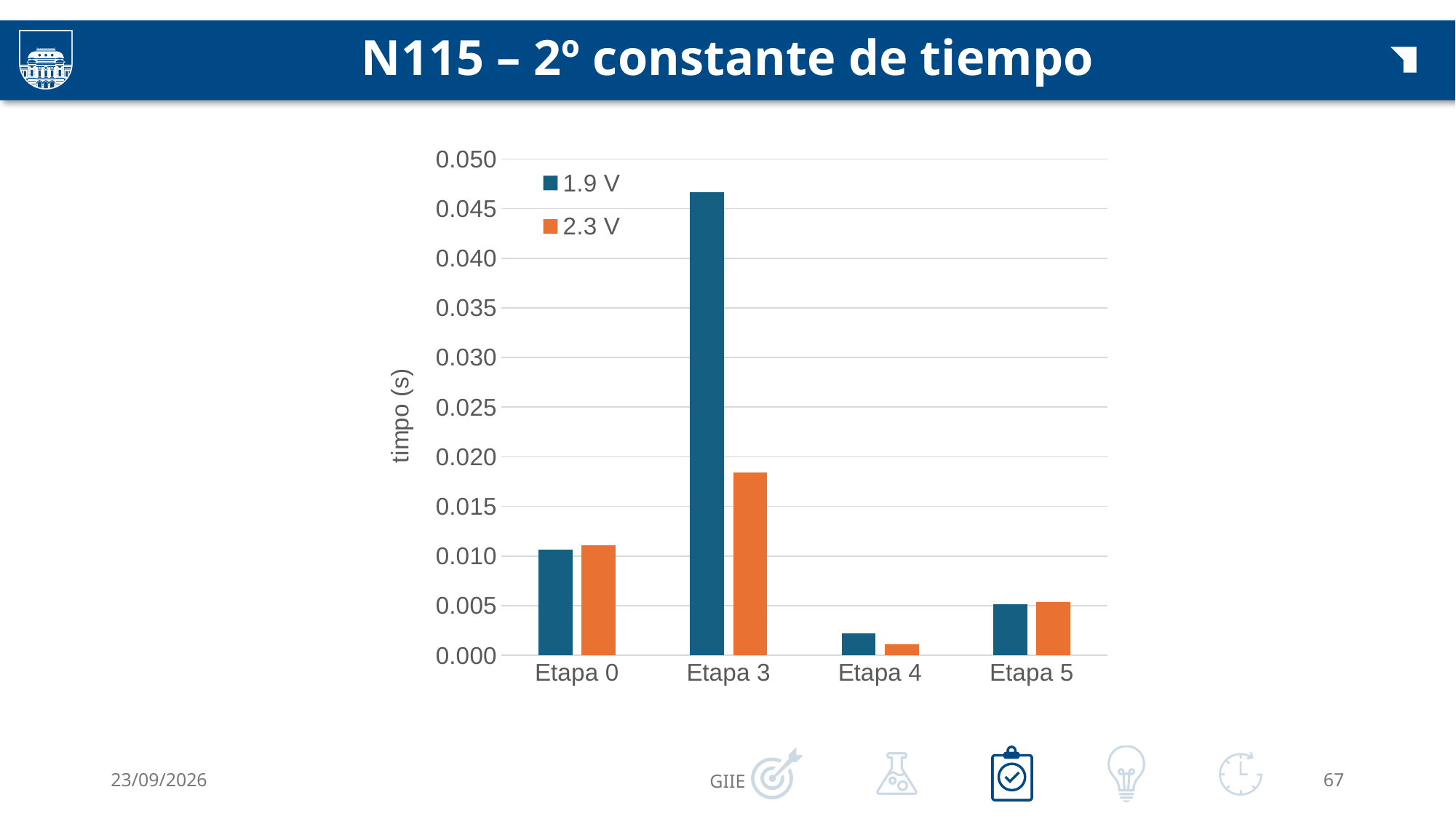
At Etapa 4, which series has the larger value, 1.9 V or 2.3 V? 1.9 V How many categories (etapas) are shown on the x axis? 4 Which etapa has the lowest value for the 2.3 V series? Etapa 4 Which etapa has the highest value for the 2.3 V series? Etapa 3 At Etapa 3, which series has the larger value, 1.9 V or 2.3 V? 1.9 V What is the label on the y axis of the chart? timpo (s) Is the value for 2.3 V at Etapa 3 greater or less than 0.015? greater Is the value for 1.9 V at Etapa 3 greater or less than 0.040? greater Which etapa has the lowest value for the 1.9 V series? Etapa 4 Which etapa has the highest value for the 1.9 V series? Etapa 3 What kind of chart is shown on the slide? bar chart How many series does the legend list? 2